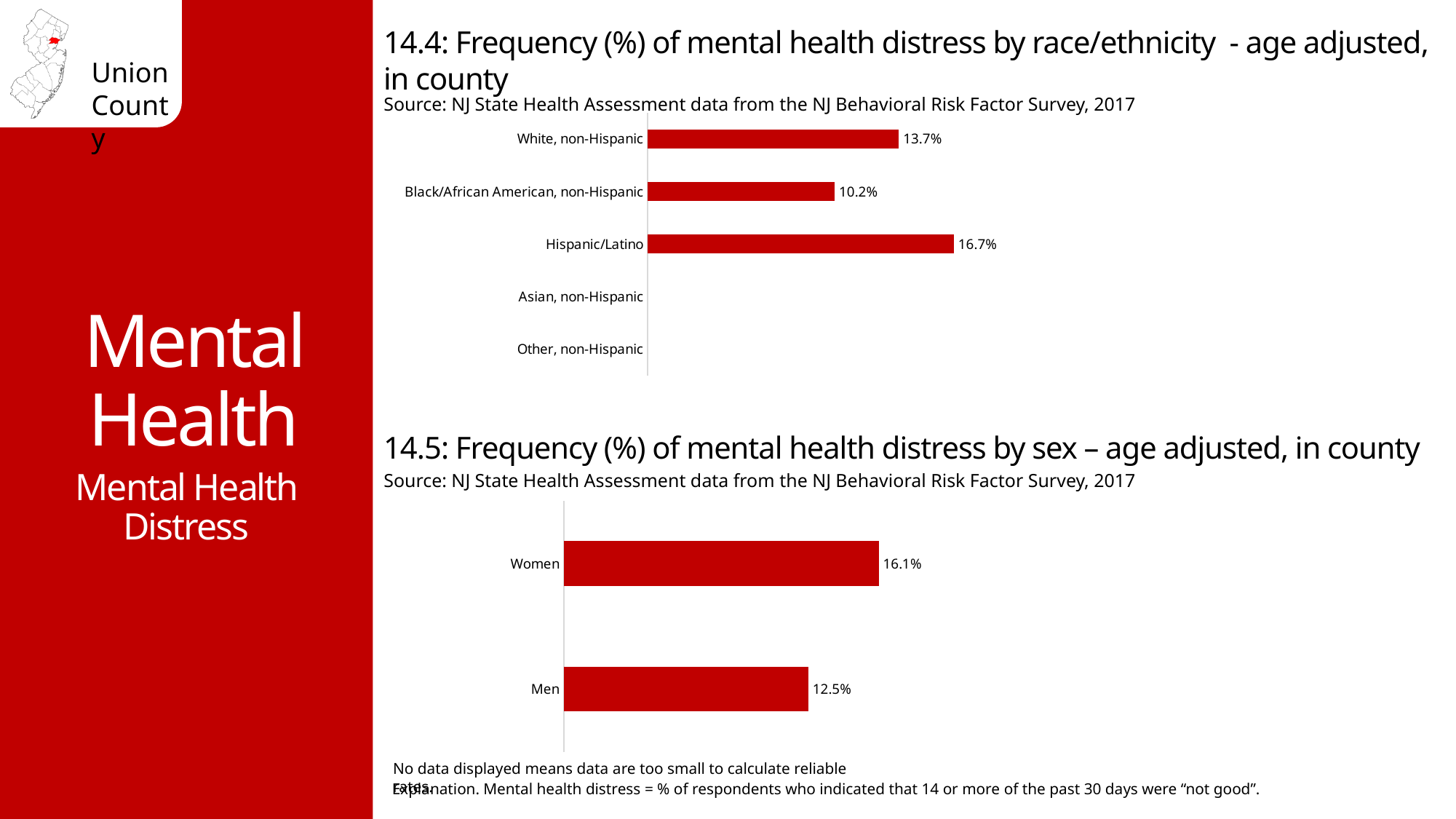
In the chart 14.4 (mental health distress by race/ethnicity), how many race/ethnicity categories are listed on the axis? 5 In the chart 14.4 (mental health distress by race/ethnicity), which categories have no bar displayed? Asian, non-Hispanic and Other, non-Hispanic In the chart 14.4 (mental health distress by race/ethnicity), what is the value for Black/African American, non-Hispanic? 10.2% In the chart 14.5 (mental health distress by sex), what is the value for Women? 16.1% In the chart 14.4 (mental health distress by race/ethnicity), what is the difference between the values for Hispanic/Latino and White, non-Hispanic? 3.0% What kind of chart is chart 14.5 (mental health distress by sex)? Bar chart In the chart 14.5 (mental health distress by sex), what is the value for Men? 12.5% In the chart 14.5 (mental health distress by sex), what is the difference between the values for Women and Men? 3.6% In the chart 14.4 (mental health distress by race/ethnicity), which race/ethnicity group has the highest value? Hispanic/Latino In the chart 14.4 (mental health distress by race/ethnicity), which group with a displayed bar has the lowest value? Black/African American, non-Hispanic In the chart 14.5 (mental health distress by sex), which is larger, the value for Women or for Men? Women In the chart 14.4 (mental health distress by race/ethnicity), what is the value for Hispanic/Latino? 16.7%